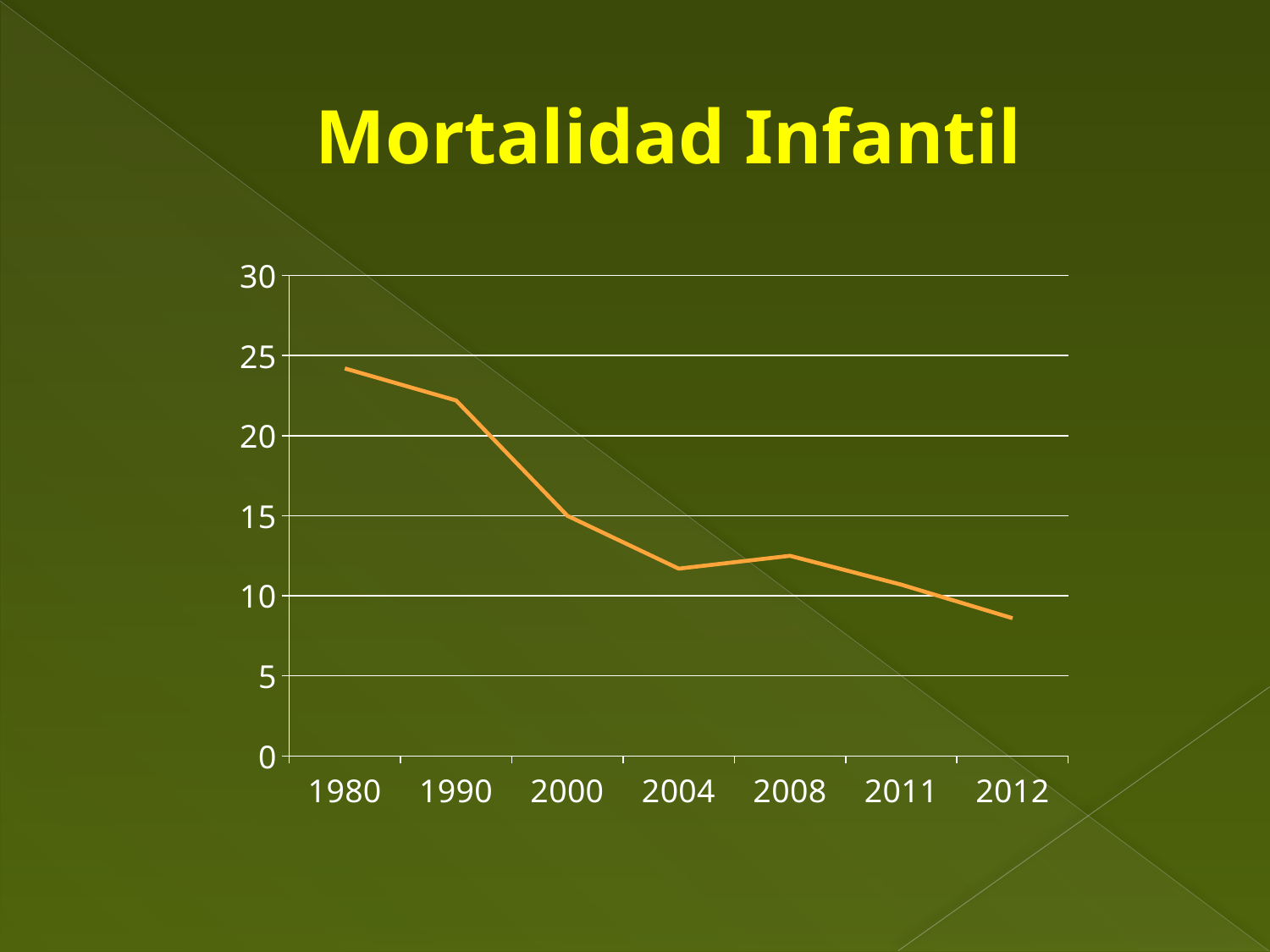
Which is larger, the value for 2004 or the value for 2008? 2008 Which is larger, the value for 1980 or the value for 2012? 1980 Which year has the highest value? 1980 What kind of chart is shown on the slide? line chart How many years are plotted on the x axis? 7 Is the value for 1990 greater or less than 25? less Which year has the lowest value? 2012 Do the values generally rise or fall from 1980 to 2012? fall What is the title of the chart? Mortalidad Infantil Is the value for 1980 greater or less than 20? greater Is the value for 2012 greater or less than 10? less